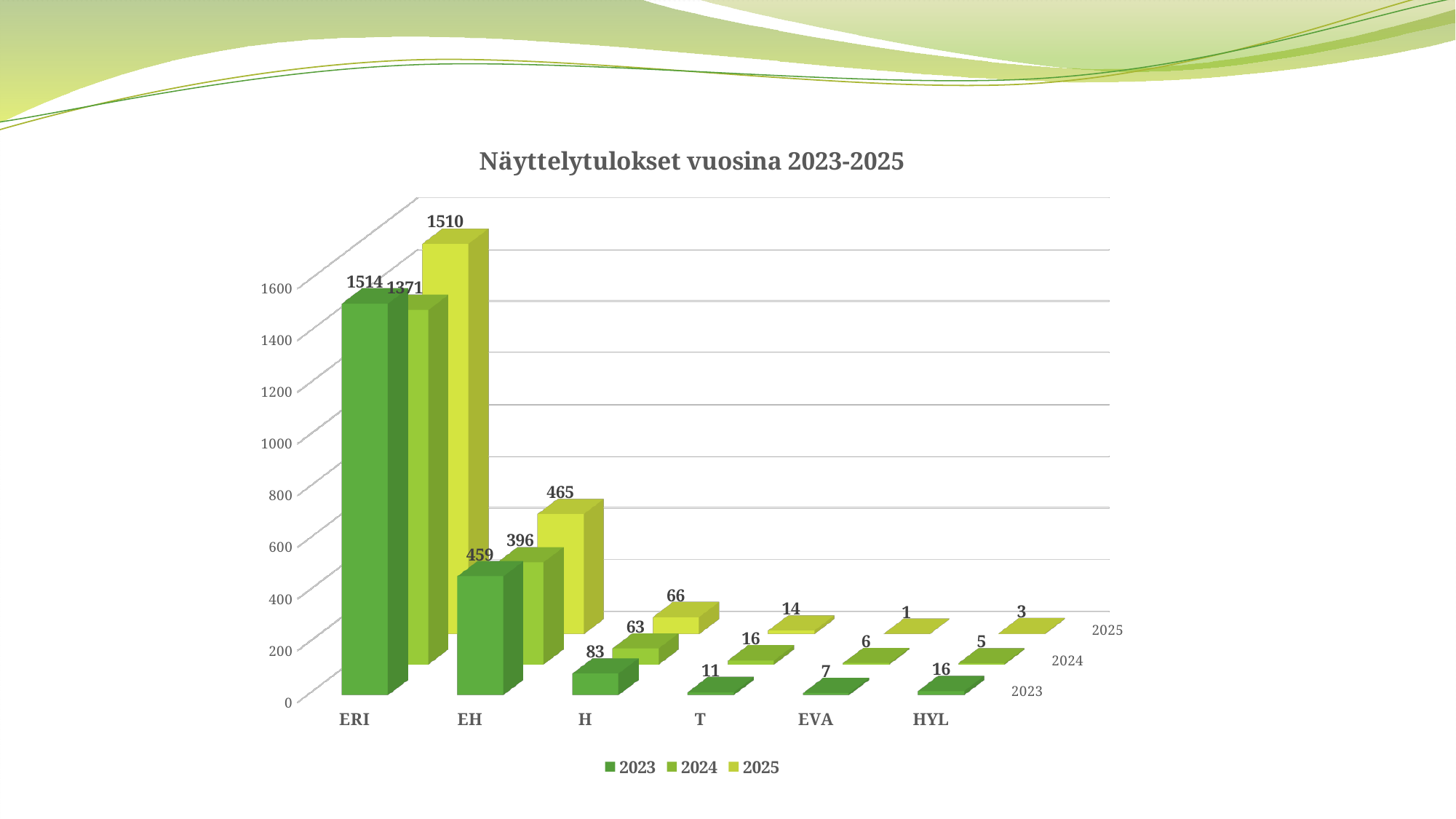
Which is larger, the 2023 value for EH or the 2024 value for EH? 2023 value for EH What is the value for H in 2024? 63 What is the title of the chart? Näyttelytulokset vuosina 2023-2025 What is the value for EH in 2025? 465 How many series does the legend list? 3 What is the value for HYL in 2023? 16 Which category has the lowest value in 2025? EVA What kind of chart is shown on the slide? Bar chart What is the difference between the 2025 and 2024 values for ERI? 139 What is the value for ERI in 2023? 1514 How many categories are shown on the x axis? 6 Which category has the highest value in 2025? ERI